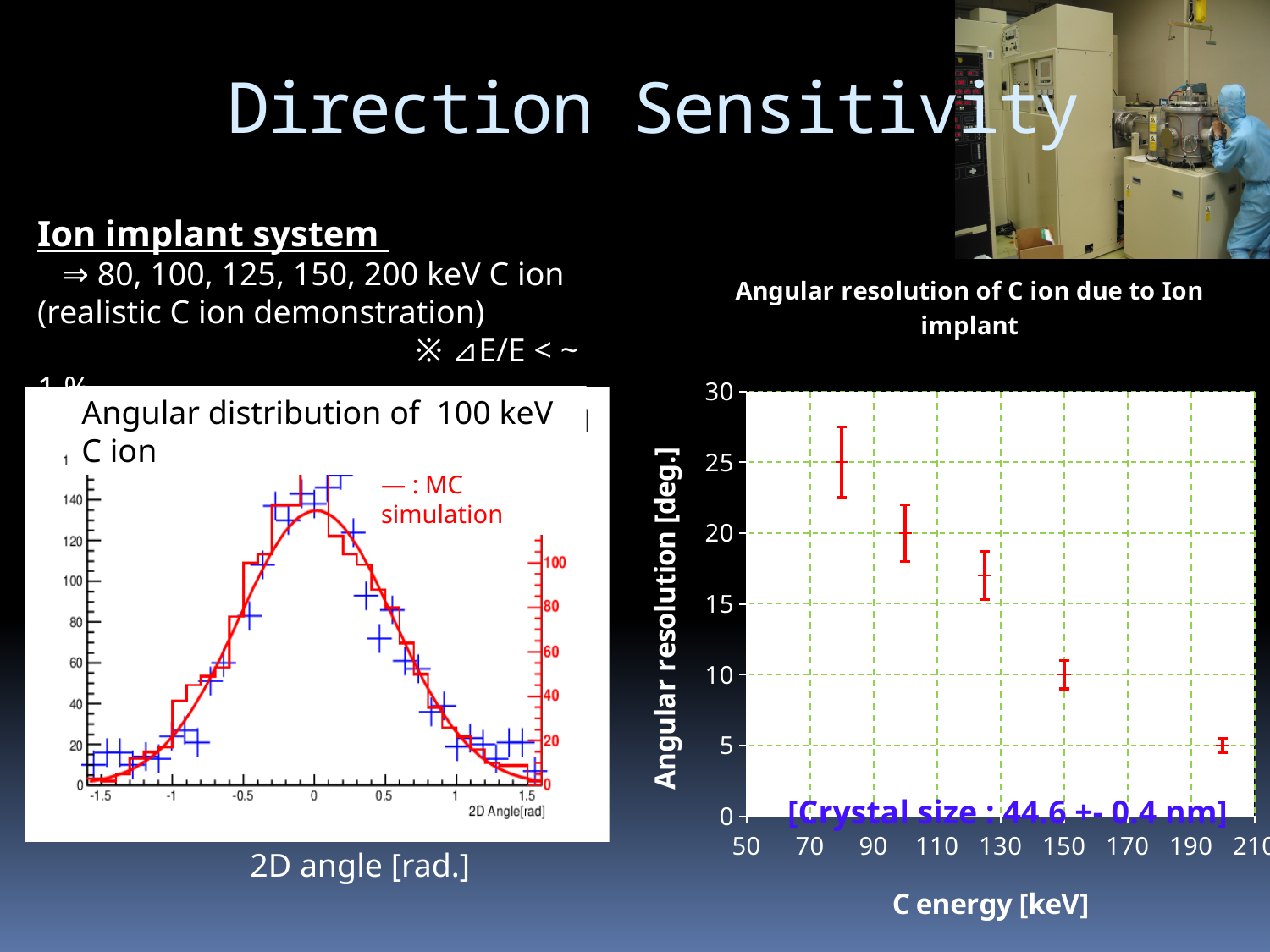
In the 'Angular resolution of C ion due to Ion implant' chart, does the angular resolution rise or fall as C energy increases? fall What crystal size is annotated on the 'Angular resolution of C ion due to Ion implant' chart? 44.6 +- 0.4 nm In the 'Angular resolution of C ion due to Ion implant' chart, at which C energy is the angular resolution highest? 80 keV In the 'Angular distribution of 100 keV C ion' chart on the left, what does the red curve represent according to the legend? MC simulation In the 'Angular resolution of C ion due to Ion implant' chart, how many data points are plotted? 5 In the 'Angular resolution of C ion due to Ion implant' chart, is the angular resolution at 150 keV greater or less than 15? less In the 'Angular resolution of C ion due to Ion implant' chart, which has the larger angular resolution: 100 keV or 150 keV? 100 keV What is the x-axis label of the 'Angular resolution of C ion due to Ion implant' chart? C energy [keV] In the 'Angular resolution of C ion due to Ion implant' chart, is the angular resolution at 200 keV greater or less than 10? less In the 'Angular resolution of C ion due to Ion implant' chart, at which C energy is the angular resolution lowest? 200 keV In the 'Angular resolution of C ion due to Ion implant' chart, is the angular resolution at 80 keV greater or less than 20? greater What kind of chart is the 'Angular resolution of C ion due to Ion implant' chart on the right? scatter plot with error bars